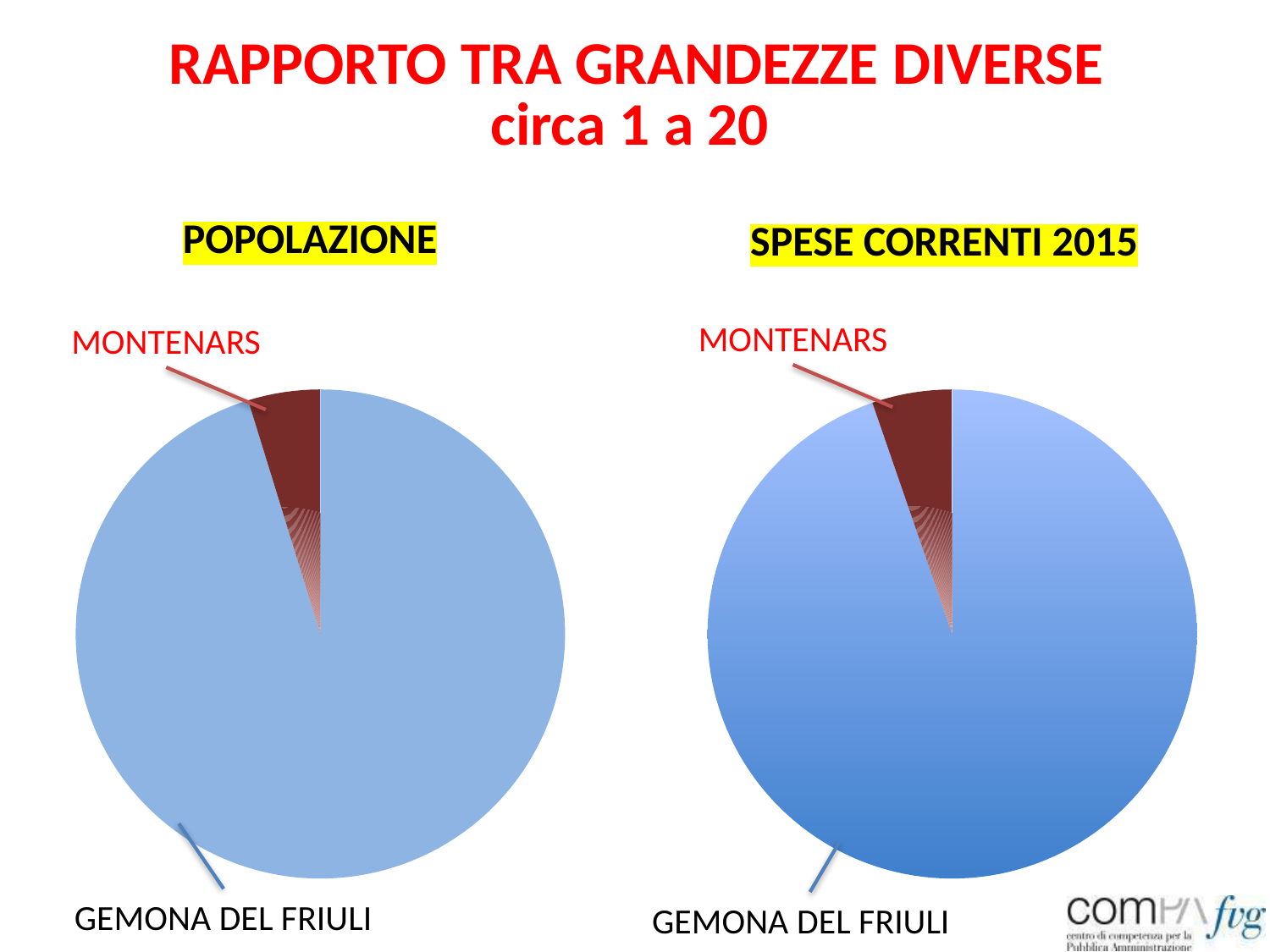
In the SPESE CORRENTI 2015 chart, which category has the largest slice? GEMONA DEL FRIULI In the SPESE CORRENTI 2015 chart, which category has the smallest slice? MONTENARS In the POPOLAZIONE chart, which category has the largest slice? GEMONA DEL FRIULI How many pie charts are shown on the slide? 2 How many slices does the SPESE CORRENTI 2015 pie chart have? 2 In the POPOLAZIONE chart, what colour is the MONTENARS slice? dark red What kind of chart is the SPESE CORRENTI 2015 chart? pie chart How many slices does the POPOLAZIONE pie chart have? 2 What kind of chart is the POPOLAZIONE chart? pie chart In the POPOLAZIONE chart, which is larger: GEMONA DEL FRIULI or MONTENARS? GEMONA DEL FRIULI In the SPESE CORRENTI 2015 chart, which is larger: MONTENARS or GEMONA DEL FRIULI? GEMONA DEL FRIULI In the POPOLAZIONE chart, which category has the smallest slice? MONTENARS